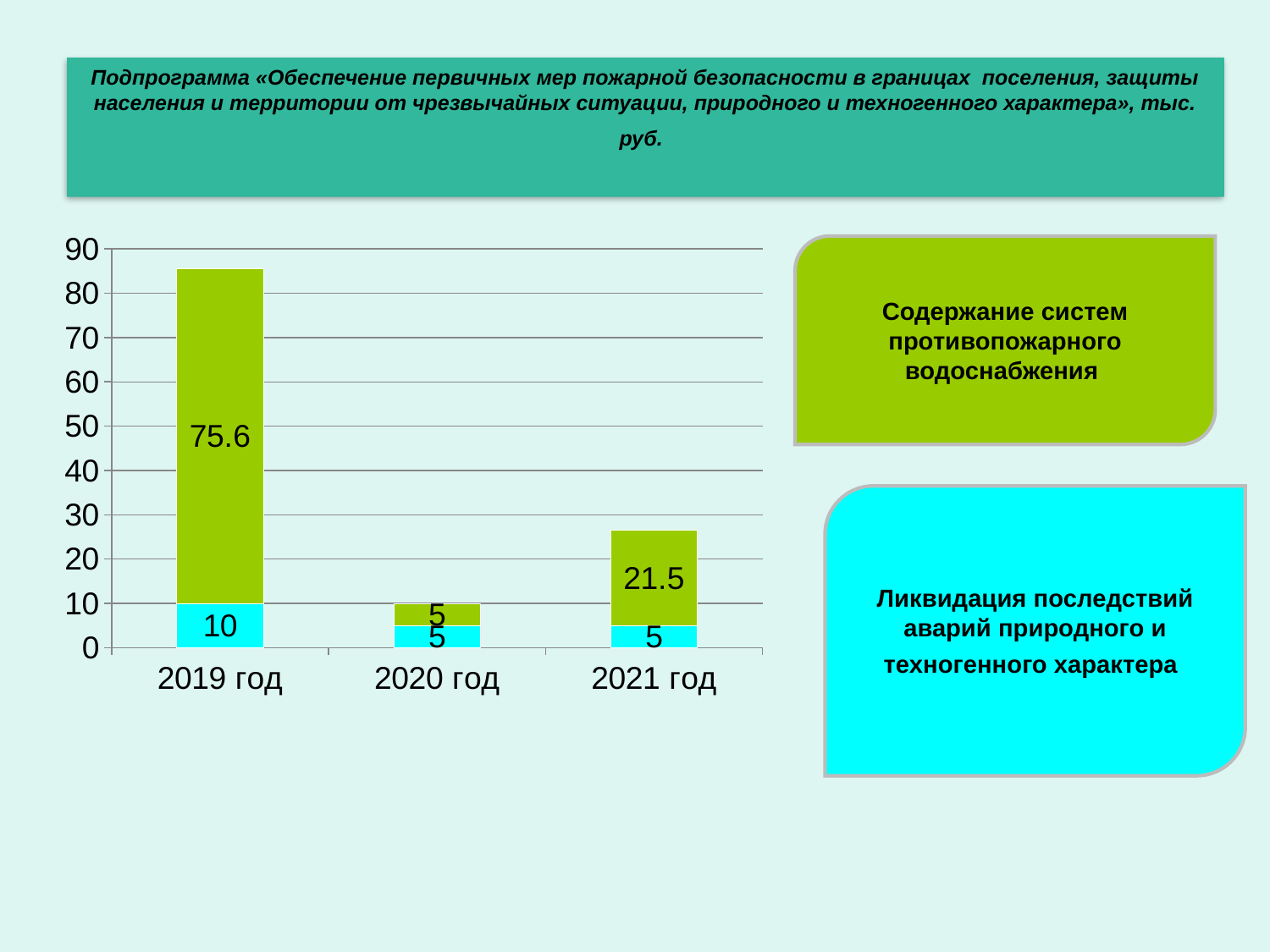
What is the difference between the "Содержание систем противопожарного водоснабжения" values for 2019 год and 2021 год? 54.1 What kind of chart is shown on the slide? Stacked bar chart In which year is the value for "Содержание систем противопожарного водоснабжения" lowest? 2020 год How many years are shown on the x axis of the chart? 3 What is the value for "Ликвидация последствий аварий природного и техногенного характера" in 2020 год? 5 In which year is the value for "Содержание систем противопожарного водоснабжения" highest? 2019 год Which is larger: the "Содержание систем противопожарного водоснабжения" value for 2021 год or for 2020 год? 2021 год What is the total of the stacked bar for 2019 год? 85.6 What is the total of the stacked bar for 2021 год? 26.5 What is the value for "Ликвидация последствий аварий природного и техногенного характера" in 2019 год? 10 What is the value for "Содержание систем противопожарного водоснабжения" in 2019 год? 75.6 What is the value for "Содержание систем противопожарного водоснабжения" in 2021 год? 21.5